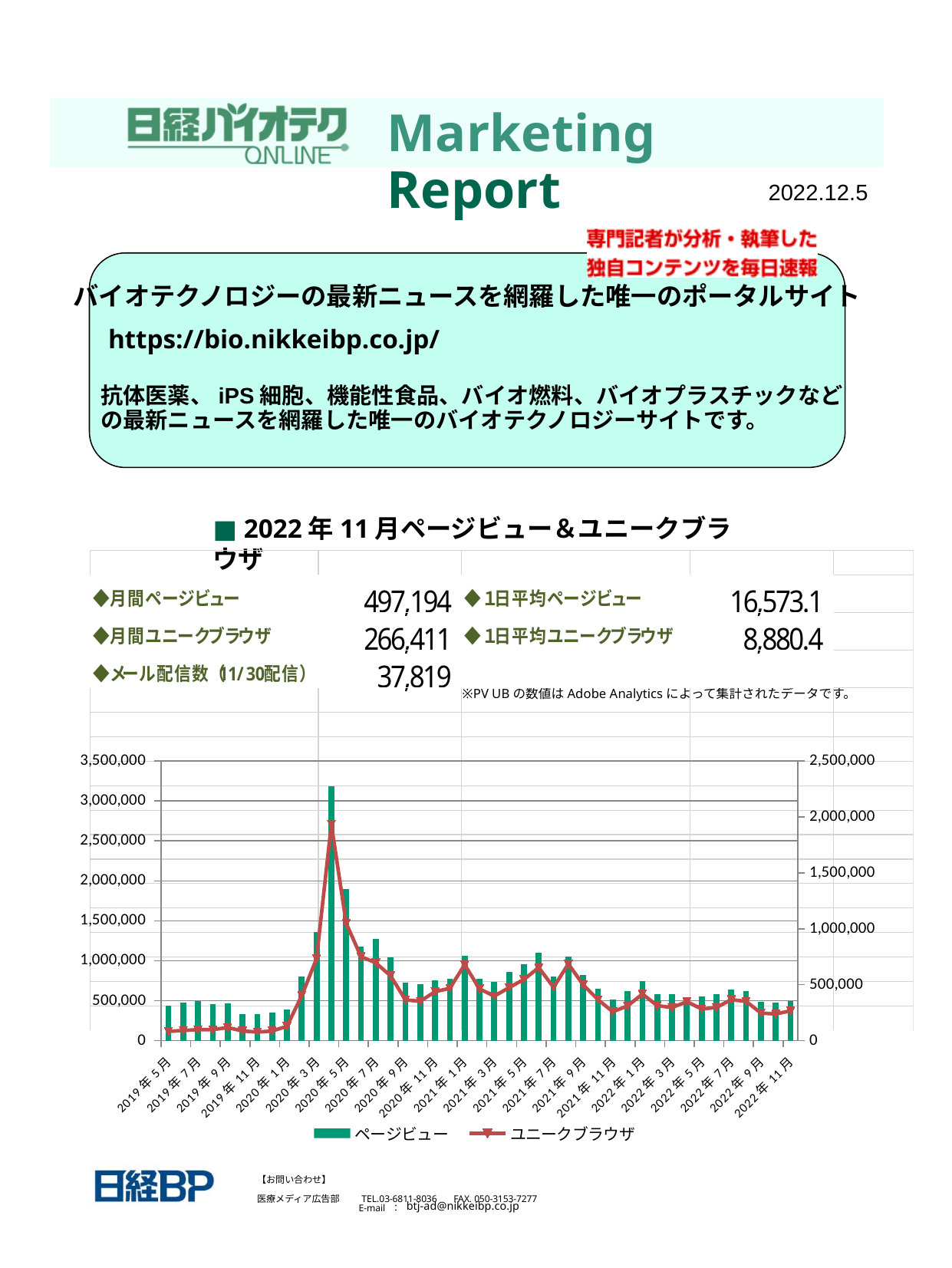
Is the ページビュー value for 2019年11月 greater or less than 500,000? less How many series does the chart legend list? 2 Do the ページビュー values rise or fall from 2020年1月 to 2020年5月? rise Do the ページビュー values rise or fall from 2020年5月 to 2020年11月? fall Is the ページビュー value for 2020年5月 greater or less than 3,000,000? less Is the ユニークブラウザ value for 2020年5月 greater or less than 1,500,000 on the right axis? less In which month does the ユニークブラウザ line reach its highest value? 2020年4月 What kind of chart is shown on the slide? A combined bar and line chart Which month has the larger ページビュー value, 2020年5月 or 2020年7月? 2020年5月 In which month does the ページビュー bar reach its highest value? 2020年4月 Which two series are listed in the chart legend? ページビュー and ユニークブラウザ What is the highest tick value shown on the left vertical axis of the chart? 3,500,000